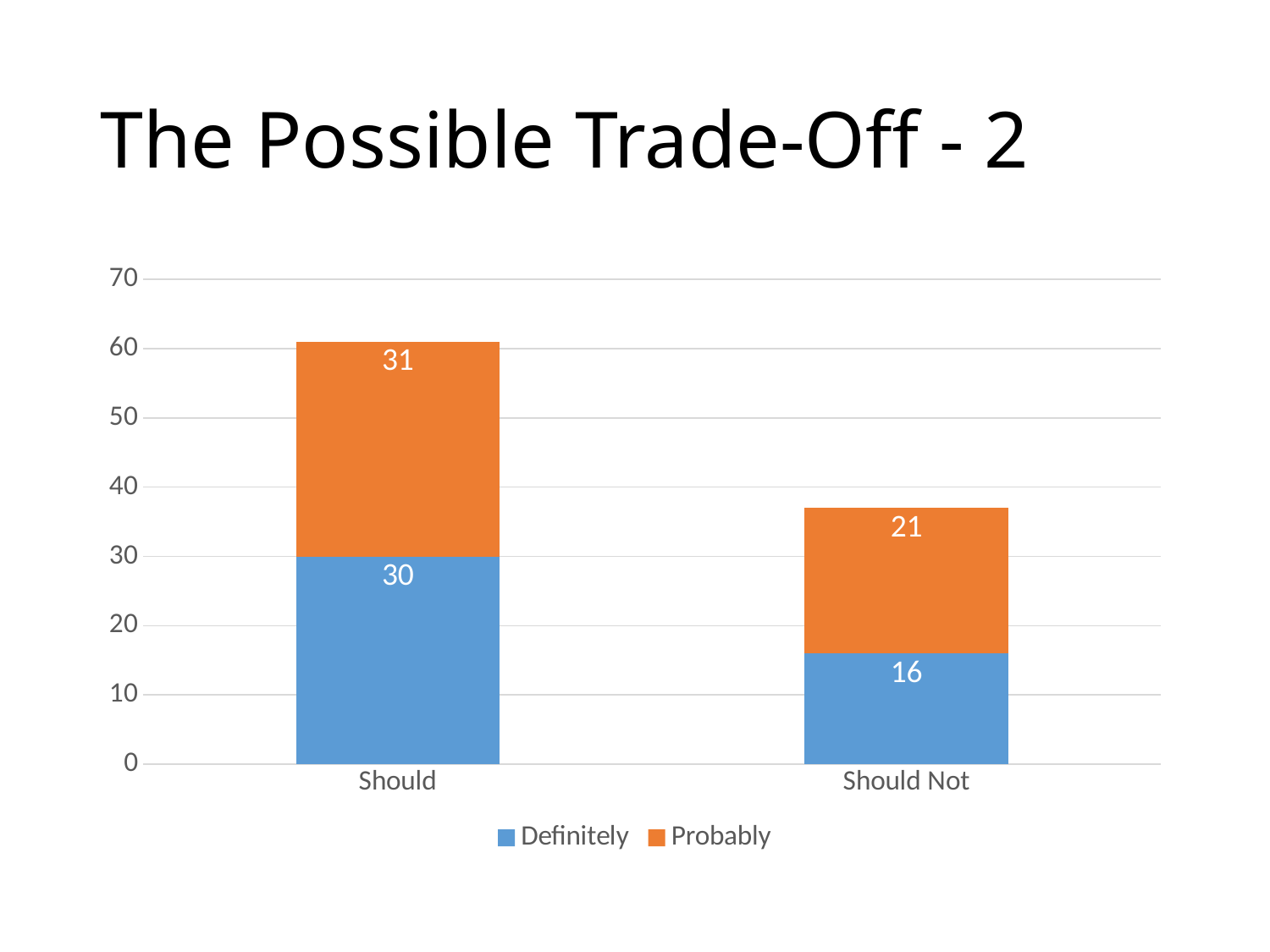
What is the value for Definitely in the Should category? 30 Which category has the taller stacked bar, Should or Should Not? Should What is the value for Probably in the Should Not category? 21 What is the value for Probably in the Should category? 31 What kind of chart is shown on the slide? Stacked bar chart What is the total of the stacked bar for Should? 61 What is the value for Definitely in the Should Not category? 16 What is the total of the stacked bar for Should Not? 37 How many categories are shown on the x axis? 2 How many series does the legend list? 2 Which category has the lowest Probably value? Should Not What is the difference between the Definitely values for Should and Should Not? 14